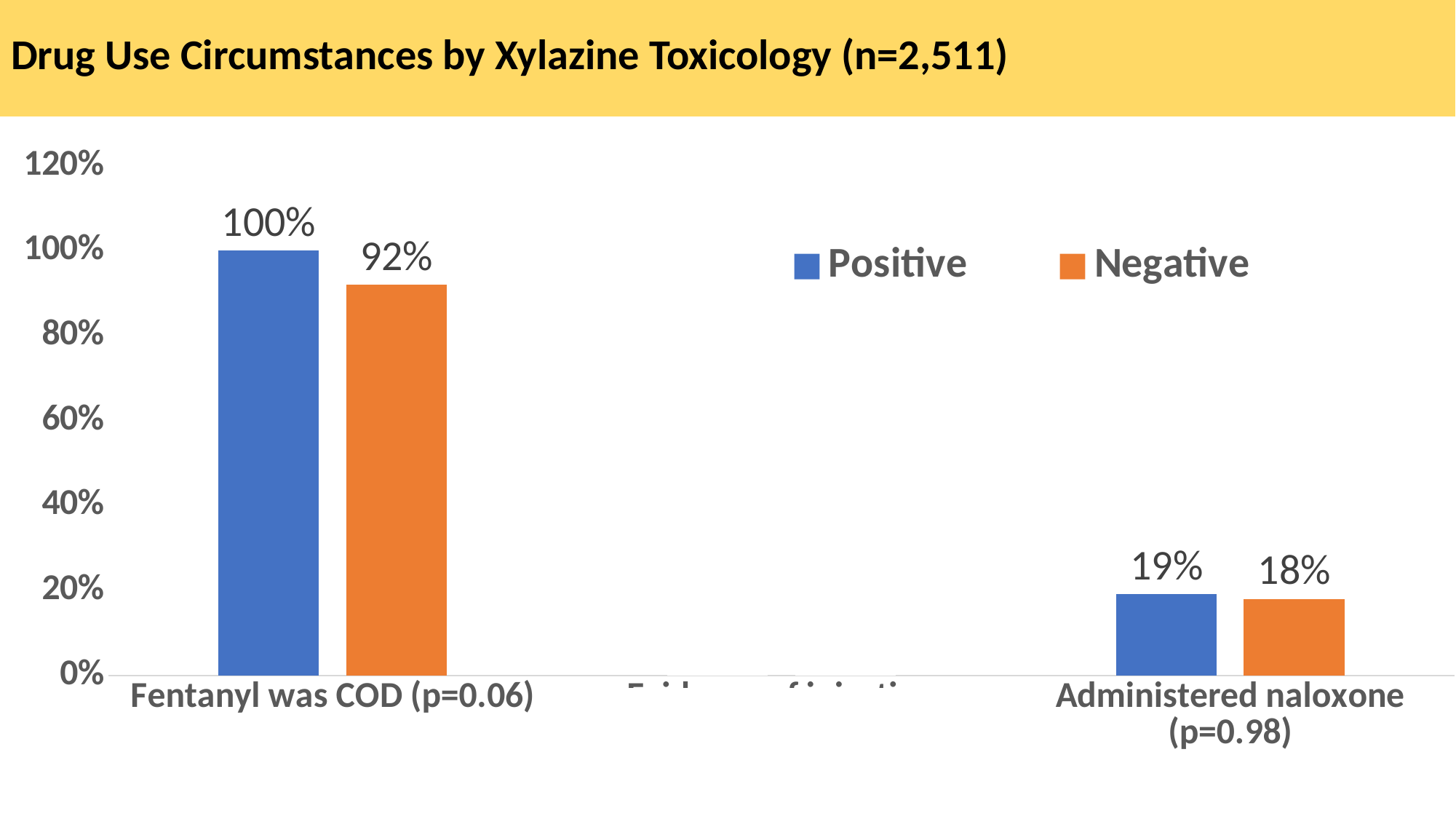
For Fentanyl was COD (p=0.06), which series has the larger value, Positive or Negative? Positive What colour represents the Negative series? Orange What is the Positive value for Administered naloxone (p=0.98)? 19% What is the difference between the Positive and Negative values for Fentanyl was COD (p=0.06)? 8% What kind of chart is shown on the slide? Bar chart What is the difference between the Positive and Negative values for Administered naloxone (p=0.98)? 1% Is the Negative value for Administered naloxone (p=0.98) greater or less than 20%? less What is the Negative value for Administered naloxone (p=0.98)? 18% Which series has the higher value for Administered naloxone (p=0.98)? Positive What is the Negative value for Fentanyl was COD (p=0.06)? 92% What is the Positive value for Fentanyl was COD (p=0.06)? 100% How many series does the legend list? 2